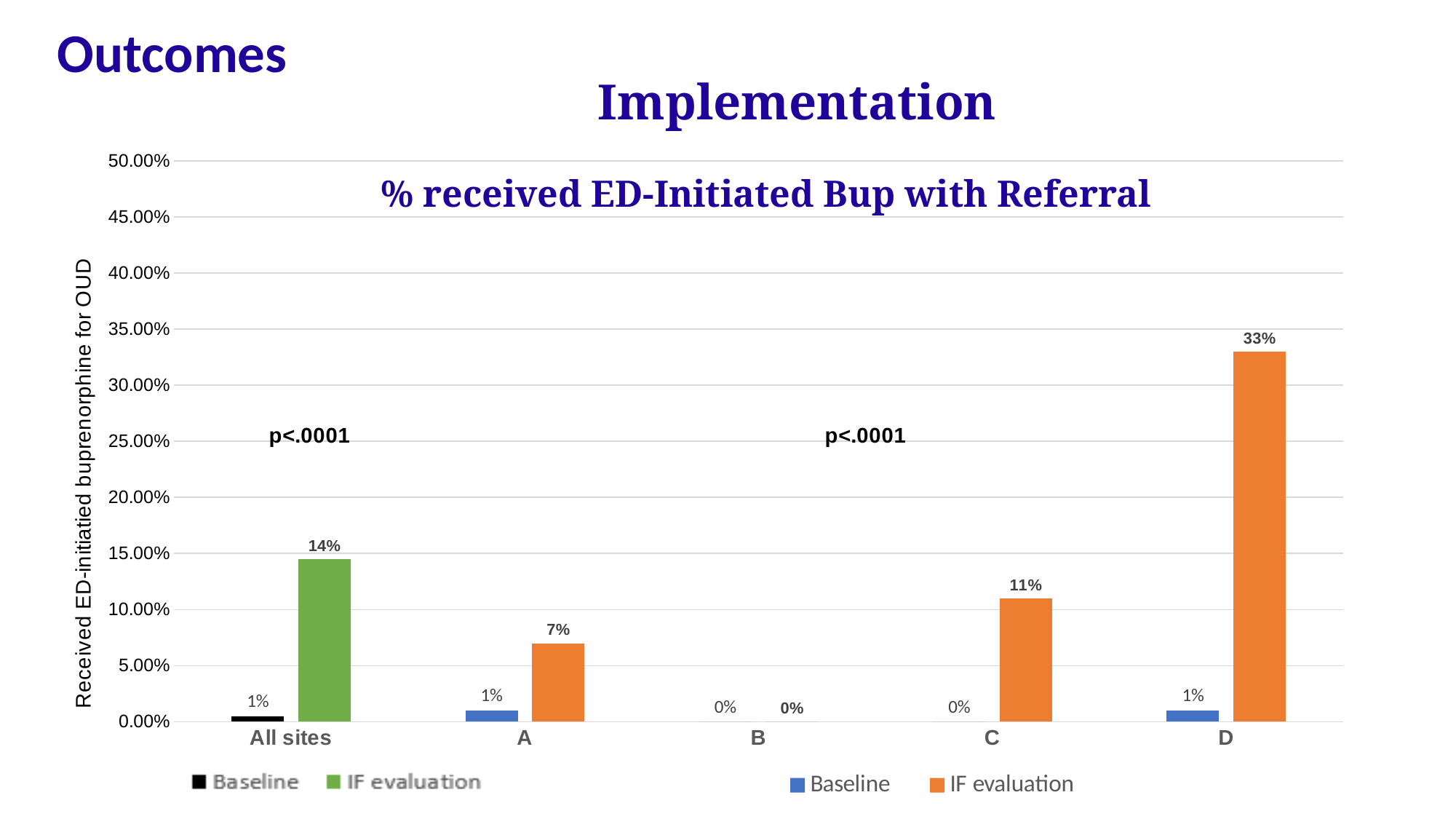
How many site categories are shown on the x axis? 5 What is the title of the chart? % received ED-Initiated Bup with Referral What is the IF evaluation value for site D? 33% Which site has the highest IF evaluation value? D How many series does the legend list? 2 What is the IF evaluation value for All sites? 14% What is the difference between the IF evaluation and Baseline values for site D? 32% What is the Baseline value for site A? 1% Which is larger, the IF evaluation value for site A or for site C? C Which site has the lowest IF evaluation value? B What is the IF evaluation value for site C? 11% What kind of chart is shown on the slide? Bar chart